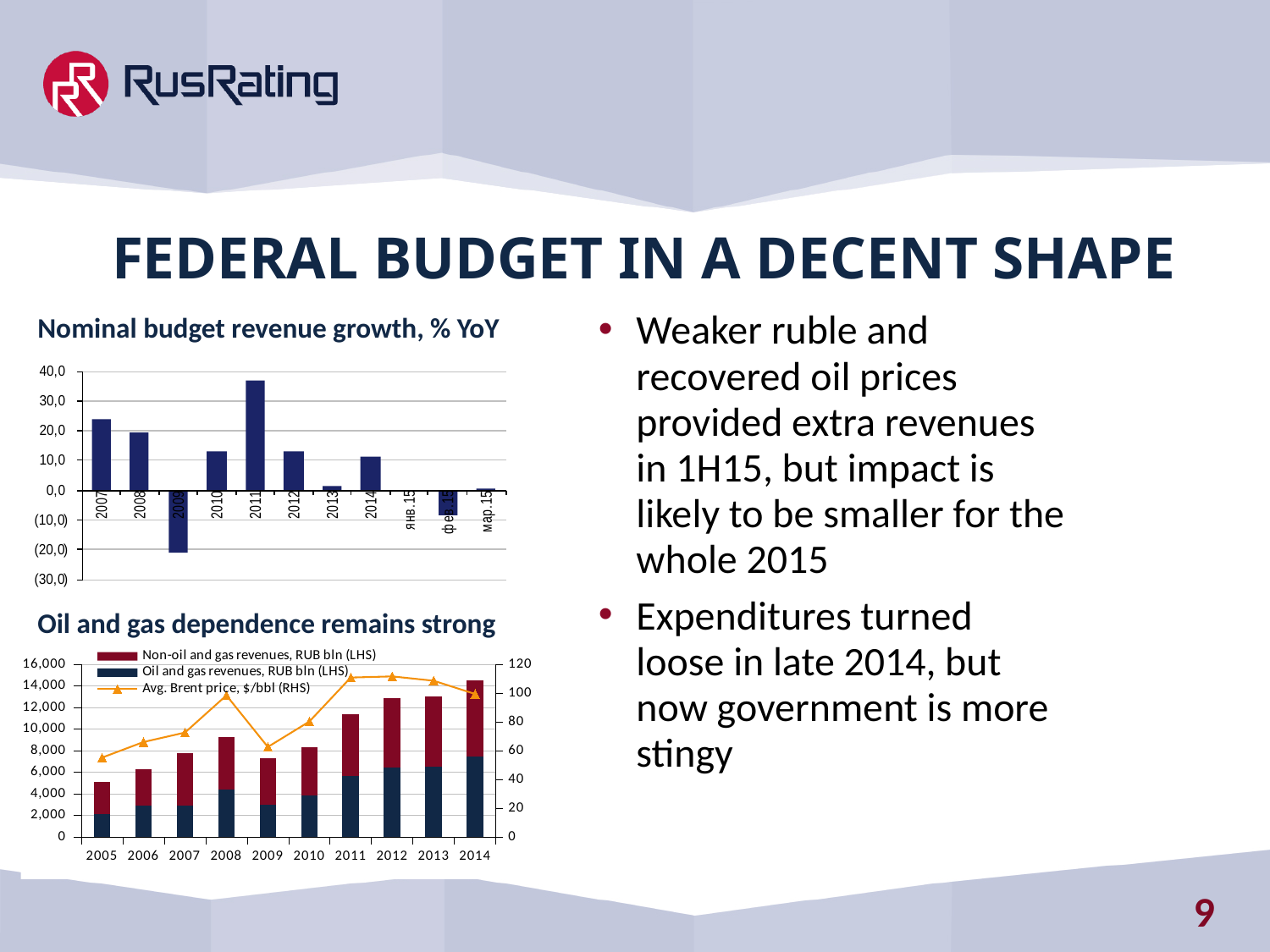
In the 'Nominal budget revenue growth, % YoY' chart, which category has the lowest value? 2009 In the 'Nominal budget revenue growth, % YoY' chart, which category has the highest value? 2011 In the 'Nominal budget revenue growth, % YoY' chart, is the value for 2009 greater or less than (10,0)? less What kind of chart is the 'Nominal budget revenue growth, % YoY' chart? bar chart How many categories are plotted in the 'Nominal budget revenue growth, % YoY' chart? 11 How many series does the legend list in the 'Oil and gas dependence remains strong' chart? 3 How many years are plotted on the x axis of the 'Oil and gas dependence remains strong' chart? 10 In the 'Nominal budget revenue growth, % YoY' chart, is the value for 2011 greater or less than 30,0? greater In the 'Oil and gas dependence remains strong' chart, which series is plotted as a line with triangle markers? Avg. Brent price, $/bbl (RHS) In the 'Oil and gas dependence remains strong' chart, is the Avg. Brent price for 2011 greater or less than 100 $/bbl? greater In the 'Nominal budget revenue growth, % YoY' chart, which is larger, the value for 2007 or the value for 2008? 2007 In the 'Oil and gas dependence remains strong' chart, which year has the tallest stacked bar? 2014